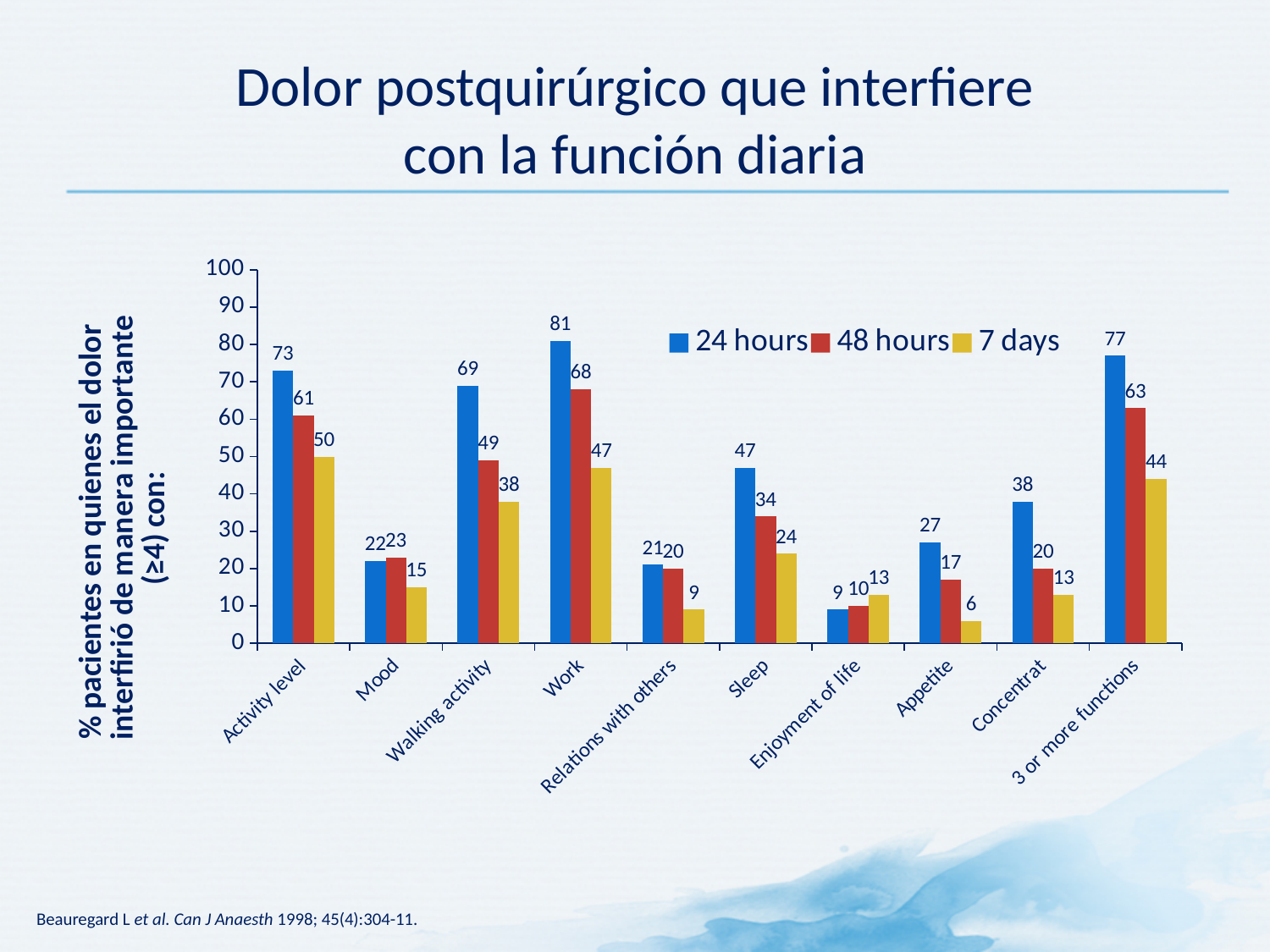
What is the difference between the 48 hours and 7 days values for 3 or more functions? 19 Which is larger for Mood: the 24 hours value or the 48 hours value? 48 hours Which series is shown in yellow in the legend? 7 days How many series does the legend list? 3 What is the value for Work in the 24 hours series? 81 What is the value for Appetite in the 48 hours series? 17 What kind of chart is shown on the slide? Bar chart How many categories are shown on the x axis? 10 Which category has the highest value in the 24 hours series? Work What is the difference between the 24 hours and 7 days values for Activity level? 23 Which category has the lowest value in the 7 days series? Appetite What is the value for Sleep in the 7 days series? 24